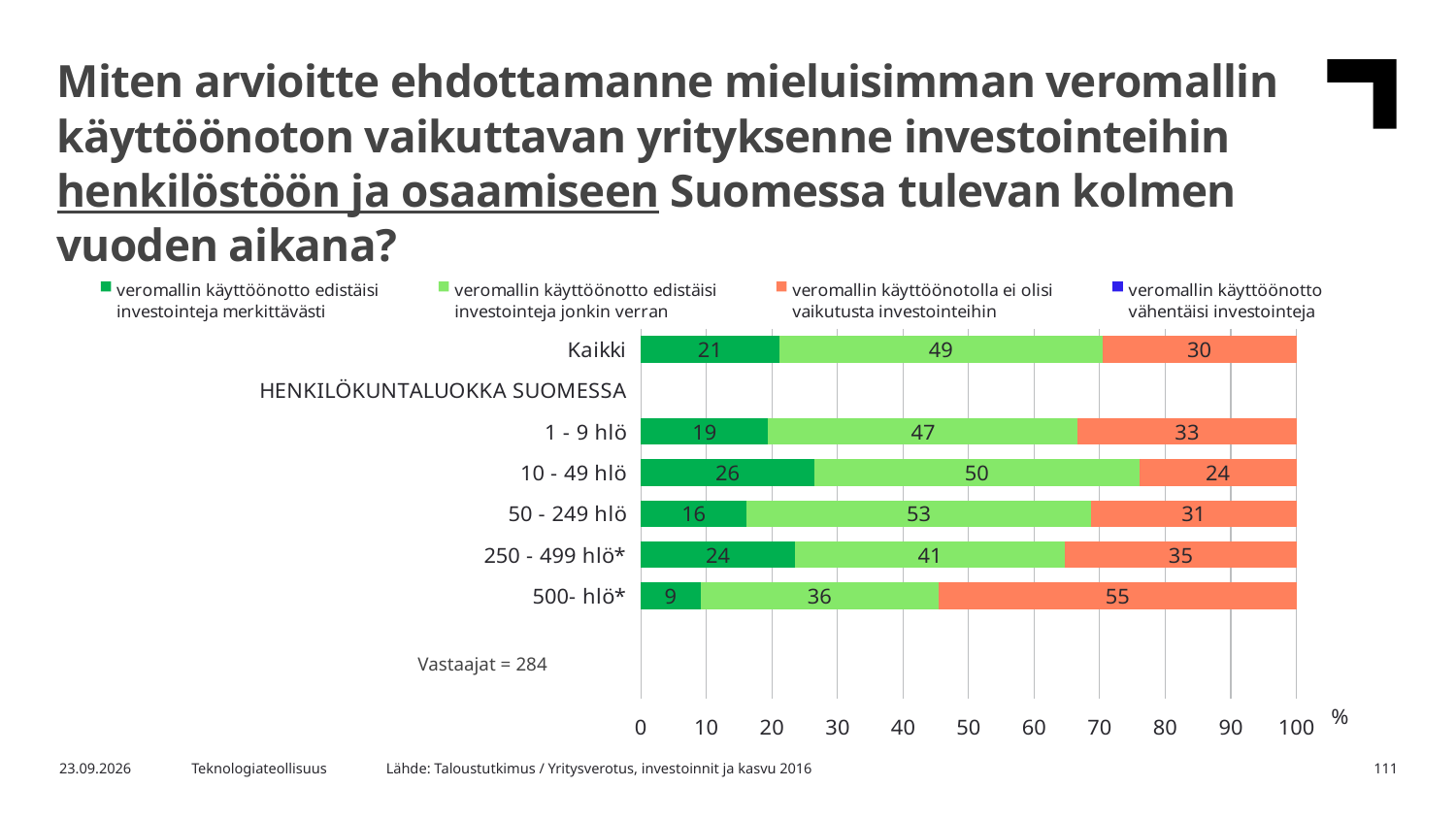
Which category has the highest value for 'veromallin käyttöönotto edistäisi investointeja merkittävästi'? 10 - 49 hlö How many bars with data are plotted in the chart? 6 What is the value for 'veromallin käyttöönotto edistäisi investointeja jonkin verran' in the '50 - 249 hlö' bar? 53 Which category has the lowest value for 'veromallin käyttöönotto edistäisi investointeja merkittävästi'? 500- hlö* What is the value for 'veromallin käyttöönotto edistäisi investointeja merkittävästi' in the 'Kaikki' bar? 21 What is the value for 'veromallin käyttöönotolla ei olisi vaikutusta investointeihin' in the '500- hlö*' bar? 55 How many respondents (Vastaajat) are stated on the slide? 284 Which is larger: the 'veromallin käyttöönotto edistäisi investointeja jonkin verran' value for '1 - 9 hlö' or for '250 - 499 hlö*'? 1 - 9 hlö What is the total of the stacked bar for '250 - 499 hlö*'? 100 What is the difference between the 'veromallin käyttöönotolla ei olisi vaikutusta investointeihin' values for '500- hlö*' and '10 - 49 hlö'? 31 What kind of chart is shown on the slide? Stacked bar chart How many series does the legend list? 4